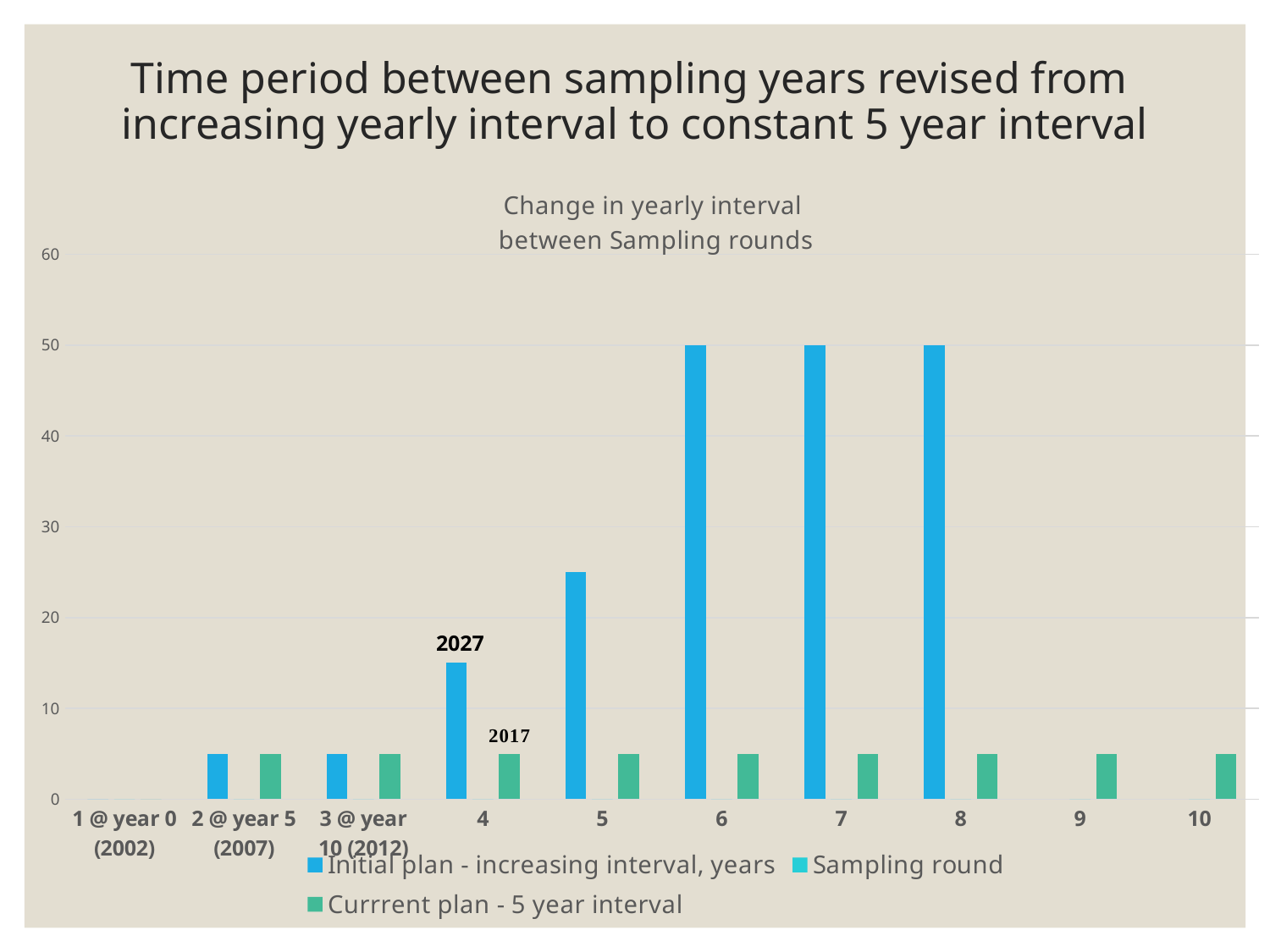
What is the title of the chart? Change in yearly interval between Sampling rounds For category 5, which series has the larger value: 'Initial plan - increasing interval, years' or 'Currrent plan - 5 year interval'? Initial plan - increasing interval, years How many categories are shown along the x axis of the chart? 10 What is the value of the 'Initial plan - increasing interval, years' series for category 8? 50 What is the value of the 'Initial plan - increasing interval, years' series for category 6? 50 What kind of chart is shown on the slide? bar chart How many series does the chart legend list? 3 Do the values of the 'Initial plan - increasing interval, years' series rise or fall from category 2 to category 8? rise Is the value of the 'Currrent plan - 5 year interval' series for category 9 greater or less than 10? less For the 'Initial plan - increasing interval, years' series, which category has the larger value: 4 or 5? 5 Is the value of the 'Initial plan - increasing interval, years' series for category 4 greater or less than 10? greater Is the value of the 'Initial plan - increasing interval, years' series for category 5 greater or less than 20? greater